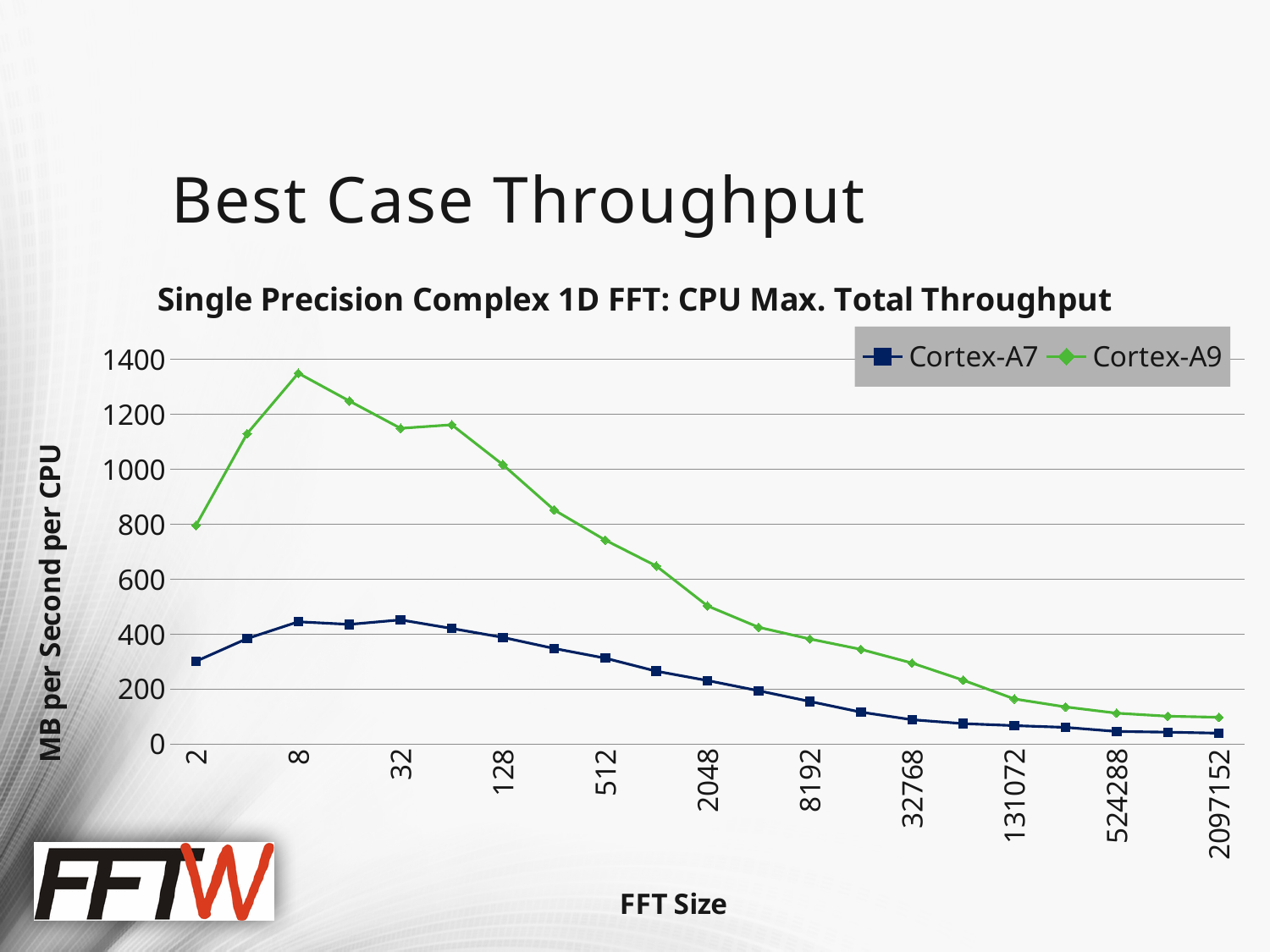
Is the Cortex-A9 value at FFT size 2048 greater or less than 400? greater Is the Cortex-A7 value at FFT size 2048 greater or less than 400? less Does the Cortex-A9 series rise or fall as FFT size increases from 8 to 2097152? fall What kind of chart is shown on the slide? line chart How many series does the legend list? 2 At FFT size 2, which series has the higher throughput, Cortex-A7 or Cortex-A9? Cortex-A9 Is the Cortex-A7 value at FFT size 128 greater or less than 200? greater At which FFT size does the Cortex-A9 series reach its highest value? 8 What is the label of the vertical axis? MB per Second per CPU What is the title of the chart? Single Precision Complex 1D FFT: CPU Max. Total Throughput